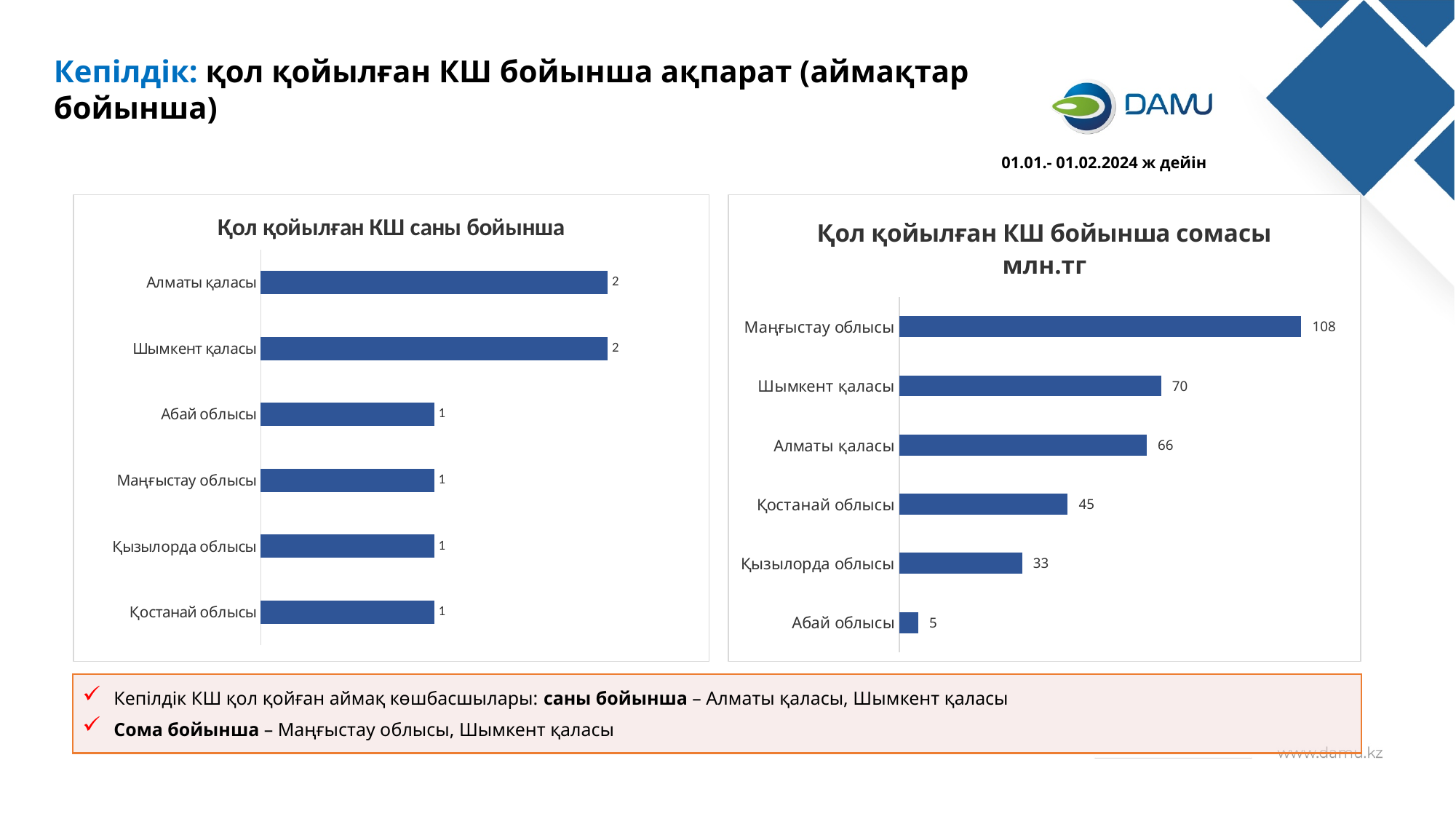
In the chart titled "Қол қойылған КШ саны бойынша", what kind of chart is it? Bar chart In the chart titled "Қол қойылған КШ бойынша сомасы млн.тг", which category has the lowest value? Абай облысы In the chart titled "Қол қойылған КШ саны бойынша", what is the value for Алматы қаласы? 2 In the chart titled "Қол қойылған КШ саны бойынша", how many categories are shown? 6 What is the title of the chart on the left side of the slide? Қол қойылған КШ саны бойынша In the chart titled "Қол қойылған КШ бойынша сомасы млн.тг", how many categories are shown? 6 In the chart titled "Қол қойылған КШ бойынша сомасы млн.тг", what is the value for Маңғыстау облысы? 108 In the chart titled "Қол қойылған КШ бойынша сомасы млн.тг", which category has the highest value? Маңғыстау облысы In the chart titled "Қол қойылған КШ бойынша сомасы млн.тг", which is larger: Қызылорда облысы or Қостанай облысы? Қостанай облысы In the chart titled "Қол қойылған КШ бойынша сомасы млн.тг", what is the value for Қостанай облысы? 45 In the chart titled "Қол қойылған КШ бойынша сомасы млн.тг", what is the difference between Шымкент қаласы and Алматы қаласы? 4 In the chart titled "Қол қойылған КШ саны бойынша", what is the value for Абай облысы? 1